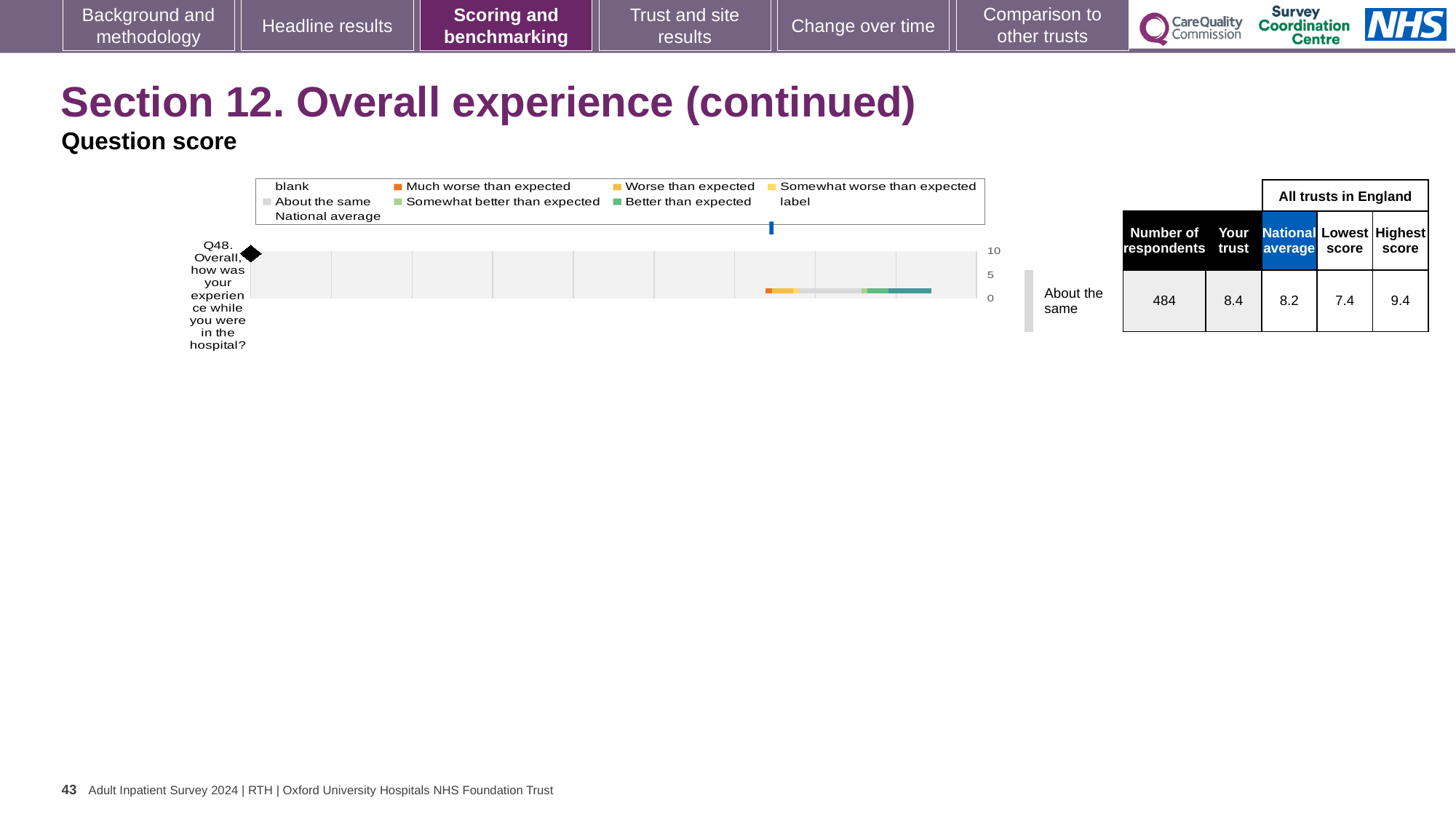
Is the national average marker for Q48 greater or less than 5 on the chart axis? greater What is the 'Your trust' score for Q48? 8.4 What is the difference between the 'Your trust' score and the national average for Q48? 0.2 Which question is plotted in the chart? Q48. Overall, how was your experience while you were in the hospital? What is the highest score among all trusts in England for Q48? 9.4 Which is larger for Q48, the 'Your trust' score or the national average? Your trust How many survey questions are plotted in the chart? 1 What is the lowest score among all trusts in England for Q48? 7.4 What is the national average score for Q48? 8.2 What kind of chart is shown on the slide? bar chart How many respondents answered Q48? 484 What benchmark category is shown for Q48 next to the chart? About the same